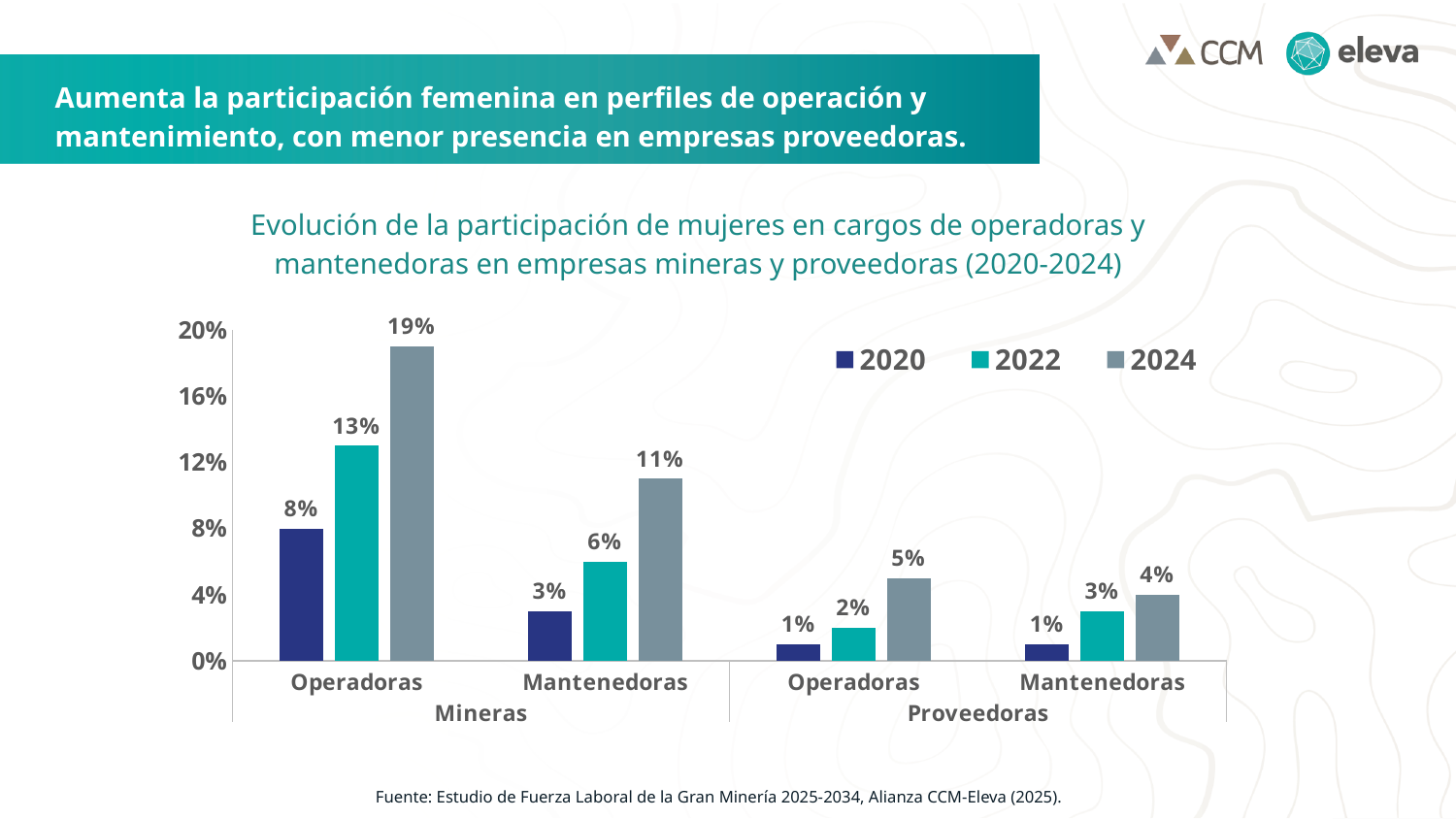
What is the value for Operadoras in Proveedoras for 2020? 1% How many series does the legend list? 3 Do the values for Operadoras in Mineras rise or fall from 2020 to 2024? Rise Which category has the lowest value for the 2022 series? Operadoras (Proveedoras) What is the value for Operadoras in Mineras for 2024? 19% Which category has the highest value for the 2024 series? Operadoras (Mineras) What is the difference between the 2024 and 2020 values for Operadoras in Mineras? 11% What is the value for Mantenedoras in Proveedoras for 2022? 3% What kind of chart is this? Bar chart How many categories are shown on the x axis? 4 Which is larger: the 2022 value for Mantenedoras in Mineras or the 2024 value for Operadoras in Proveedoras? Mantenedoras in Mineras (2022) What is the difference between the 2024 values for Mantenedoras in Mineras and Mantenedoras in Proveedoras? 7%